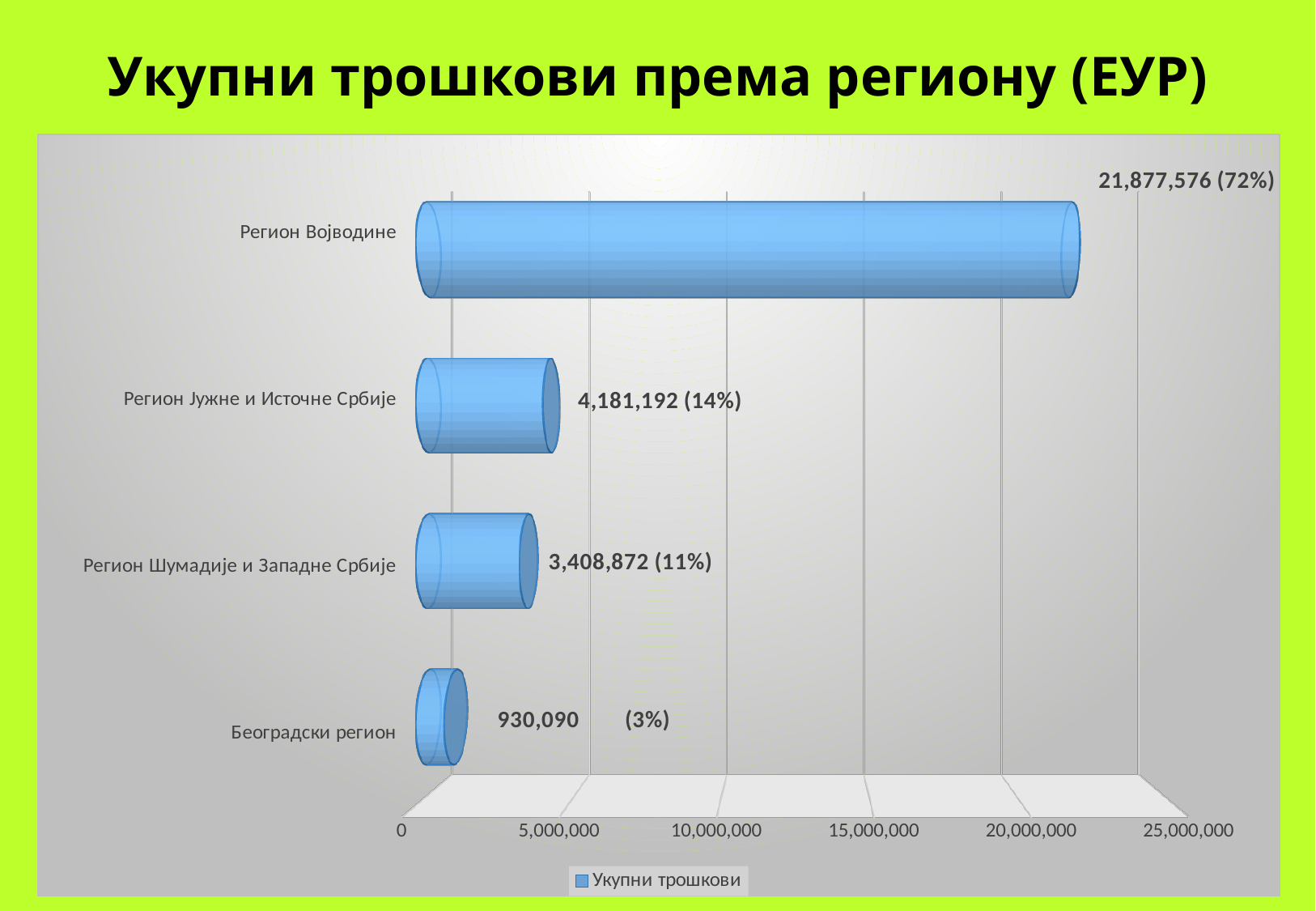
Which region has the lowest total costs? Београдски регион What is the value for Регион Војводине? 21,877,576 What type of chart is shown on the slide? bar chart What is the value for Регион Јужне и Источне Србије? 4,181,192 What is the value for Регион Шумадије и Западне Србије? 3,408,872 How many regions are shown in the chart? 4 Which is larger, the value for Регион Шумадије и Западне Србије or Београдски регион? Регион Шумадије и Западне Србије What percentage share is shown for Регион Војводине? 72% Which region has the highest total costs? Регион Војводине What is the value for Београдски регион? 930,090 Is the value for Регион Војводине greater or less than 20,000,000? greater What is the difference between the values for Регион Јужне и Источне Србије and Регион Шумадије и Западне Србије? 772,320